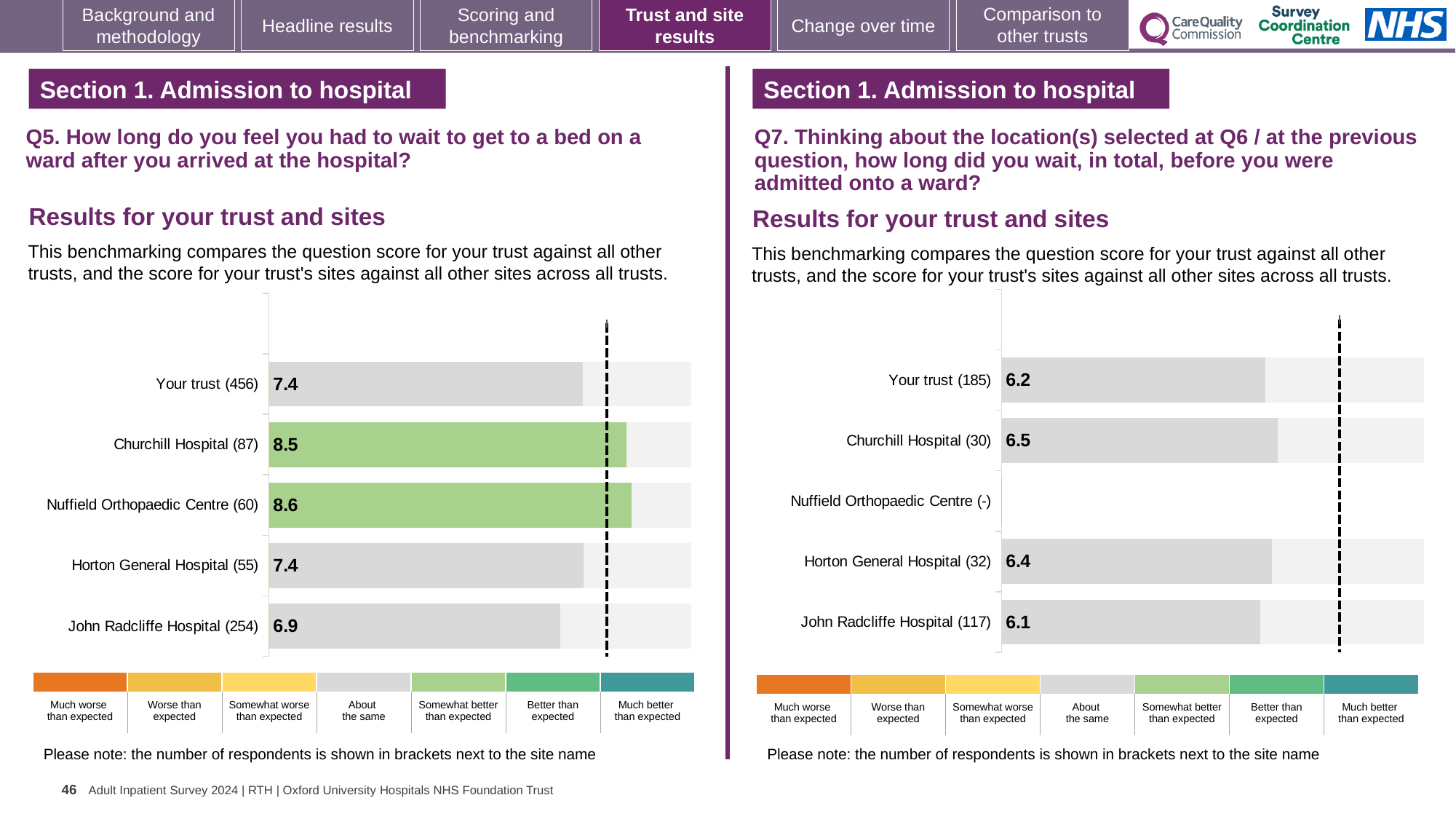
What kind of chart is used on the left side of the slide for Q5? bar chart In the Q7 chart on the right, what is the score for Horton General Hospital? 6.4 In the Q7 chart on the right, what is the score for Your trust? 6.2 In the Q7 chart on the right, what is the difference between the scores for Churchill Hospital and John Radcliffe Hospital? 0.4 In the Q5 chart on the left, which site has the highest score? Nuffield Orthopaedic Centre In the Q5 chart on the left, what is the score for John Radcliffe Hospital? 6.9 In the Q5 chart on the left, what is the difference between the scores for Nuffield Orthopaedic Centre and John Radcliffe Hospital? 1.7 In the Q5 chart on the left, which site has the lowest score? John Radcliffe Hospital In the Q7 chart on the right, is the score for Churchill Hospital larger or smaller than the score for John Radcliffe Hospital? larger In the Q7 chart on the right, which site with a score shown has the highest score? Churchill Hospital In the Q5 chart on the left, how many respondents are shown for Your trust? 456 In the Q5 chart on the left, what is the score for Churchill Hospital? 8.5